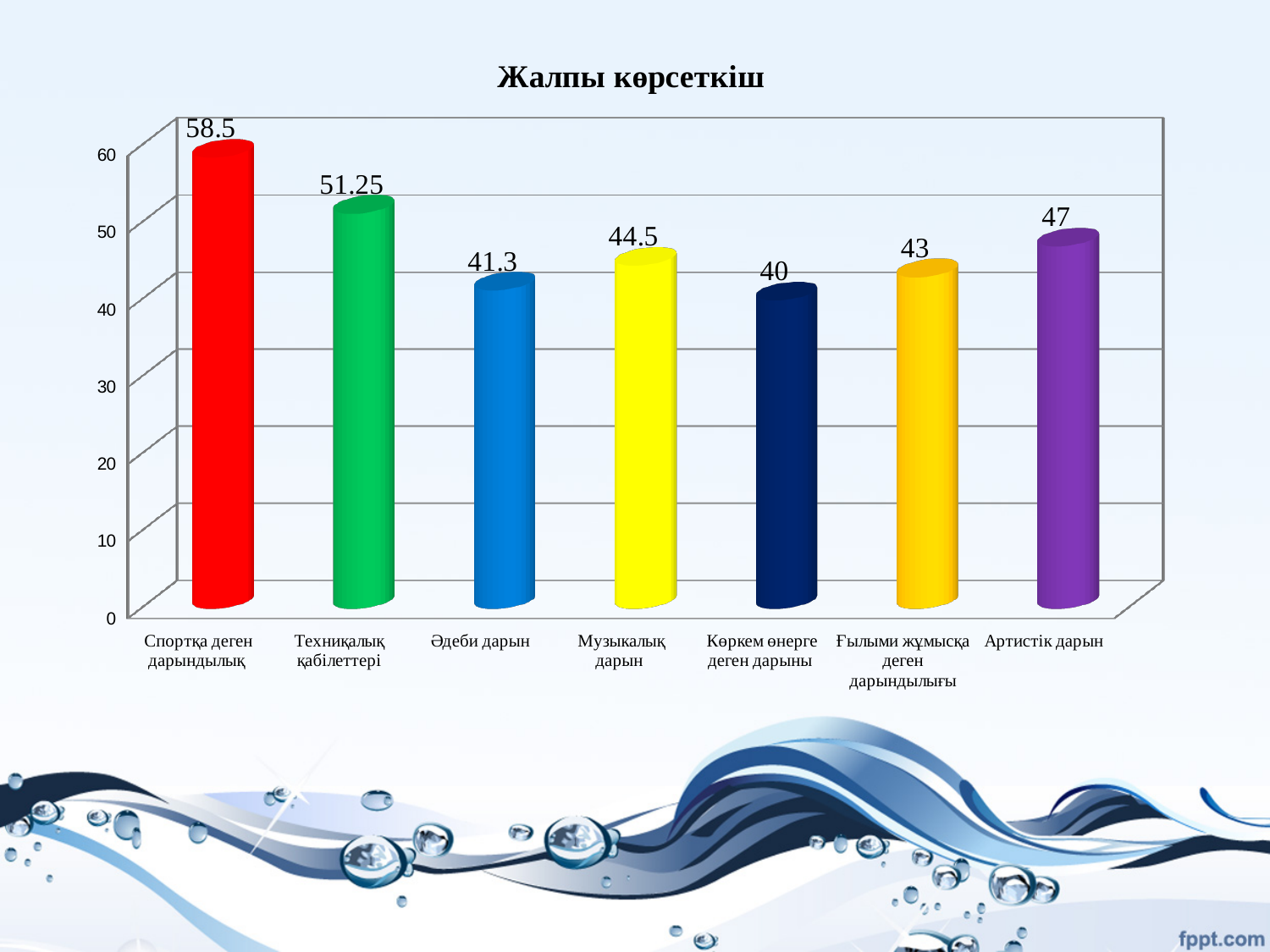
What is the difference between the values for Спортқа деген дарындылық and Артистік дарын? 11.5 What is the value for Ғылыми жұмысқа деген дарындылығы? 43 Which category has the lowest value? Көркем өнерге деген дарыны What is the value for Әдеби дарын? 41.3 How many categories are shown in the chart? 7 What kind of chart is shown on the slide? bar chart Which category has the highest value? Спортқа деген дарындылық Is the value for Техниқалық қабілеттері greater or less than 50? greater What is the value for Техниқалық қабілеттері? 51.25 What is the title of the chart? Жалпы көрсеткіш What is the value for Спортқа деген дарындылық? 58.5 Which is larger, the value for Музыкалық дарын or the value for Артистік дарын? Артистік дарын